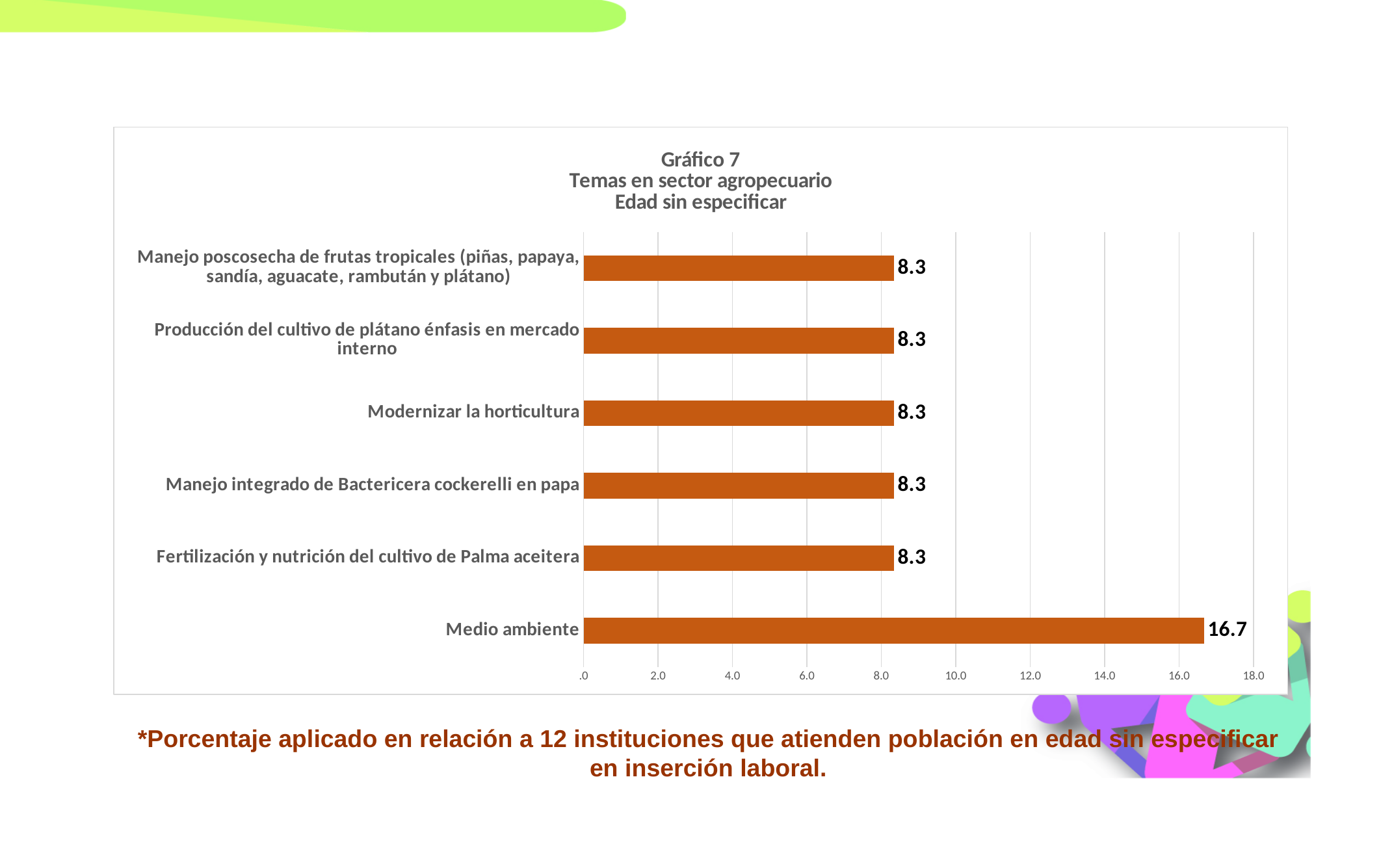
What kind of chart is shown on the slide? Bar chart What is the value for Fertilización y nutrición del cultivo de Palma aceitera? 8.3 What is the value for Modernizar la horticultura? 8.3 How many categories have a value of 8.3? 5 Which is larger: the value for Medio ambiente or the value for Producción del cultivo de plátano énfasis en mercado interno? Medio ambiente How many categories are shown in the chart? 6 What is the title of the chart? Gráfico 7 Temas en sector agropecuario Edad sin especificar Is the value for Modernizar la horticultura greater or less than 10.0? less Is the value for Medio ambiente greater or less than 14.0? greater What is the difference between the value for Medio ambiente and the value for Manejo integrado de Bactericera cockerelli en papa? 8.4 What is the value for Medio ambiente? 16.7 Which category has the highest value? Medio ambiente